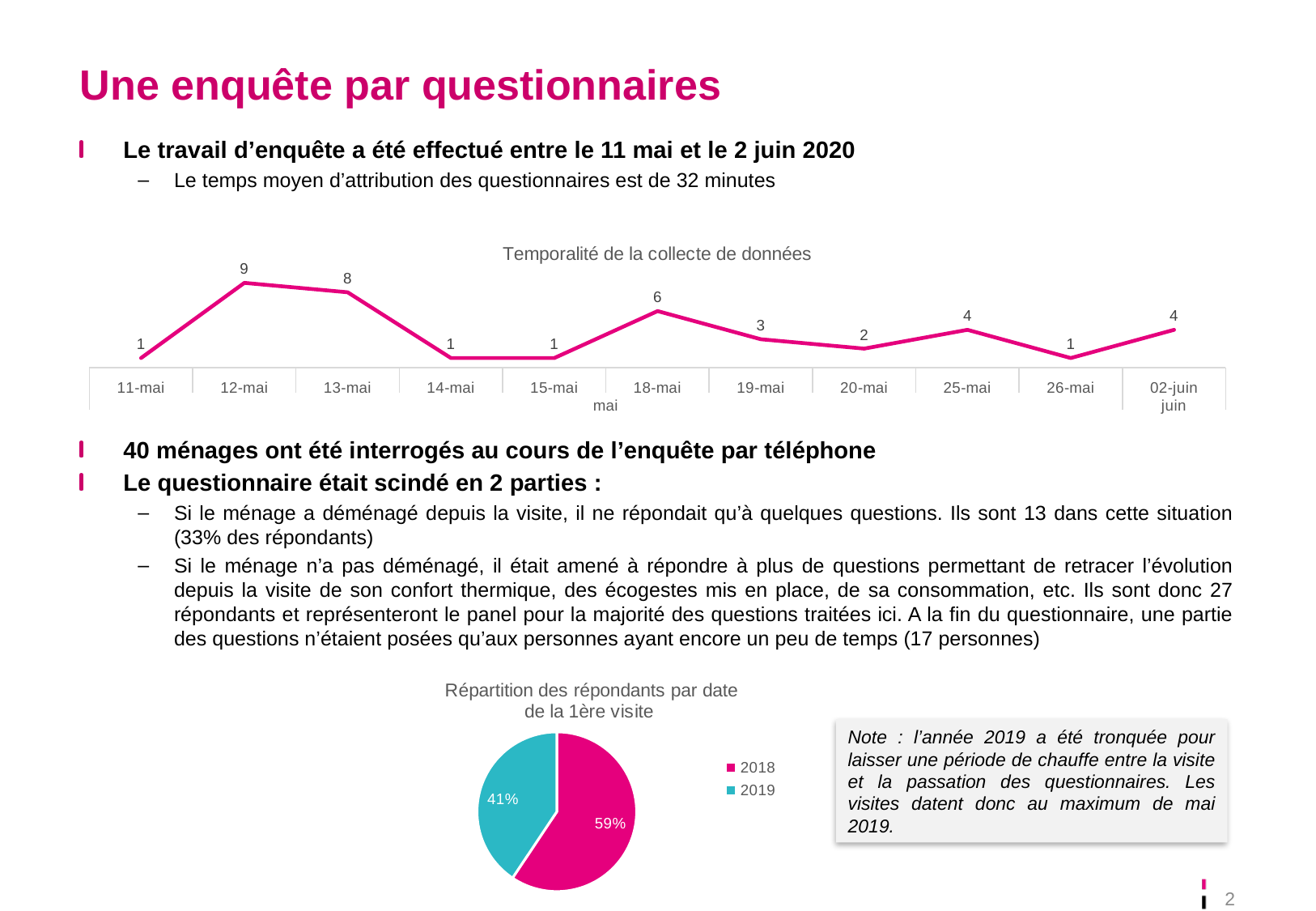
In the pie chart 'Répartition des répondants par date de la 1ère visite', what share is 2018? 59% What kind of chart is 'Temporalité de la collecte de données'? Line chart In the pie chart 'Répartition des répondants par date de la 1ère visite', how many entries does the legend list? 2 In the chart 'Temporalité de la collecte de données', does the value rise or fall from 11-mai to 12-mai? Rise In the pie chart 'Répartition des répondants par date de la 1ère visite', which year has the larger share? 2018 In the chart 'Temporalité de la collecte de données', what is the value for 12-mai? 9 In the chart 'Temporalité de la collecte de données', which is larger, the value for 25-mai or the value for 20-mai? 25-mai In the chart 'Temporalité de la collecte de données', how many dates are plotted on the x axis? 11 In the chart 'Temporalité de la collecte de données', what is the value for 18-mai? 6 In the chart 'Temporalité de la collecte de données', which date has the highest value? 12-mai In the pie chart 'Répartition des répondants par date de la 1ère visite', what share is 2019? 41% In the chart 'Temporalité de la collecte de données', what is the difference between the values for 13-mai and 19-mai? 5